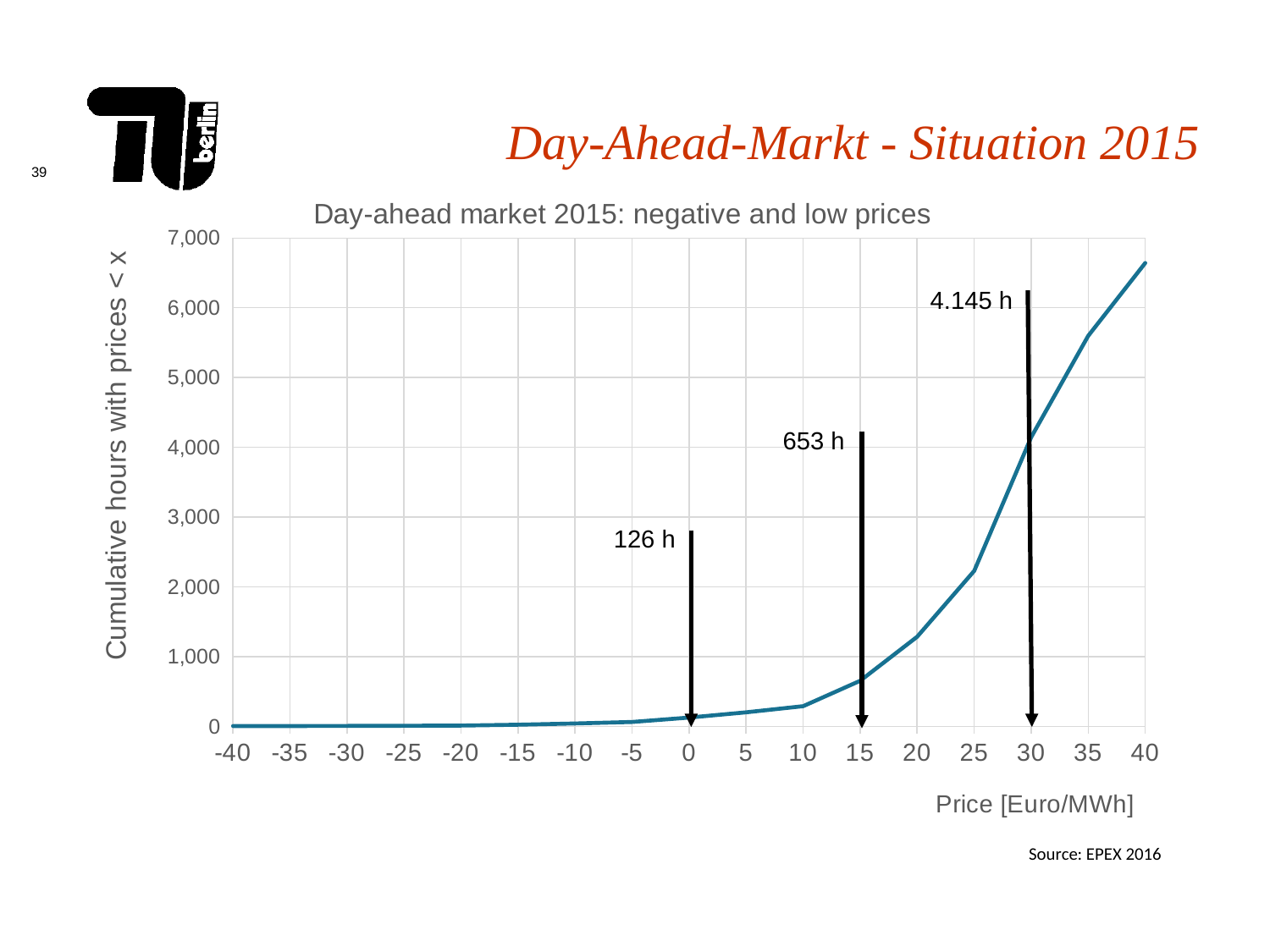
Do the cumulative hours rise or fall as the price increases along the x axis? rise Is the value at a price of -20 Euro/MWh greater or less than 1,000? less What is the label of the x axis? Price [Euro/MWh] According to the annotation, how many cumulative hours had prices below 15 Euro/MWh? 653 h What is the difference between the annotated hours at 15 Euro/MWh and at 0 Euro/MWh? 527 h Is the value at a price of 25 Euro/MWh greater or less than 2,000? greater Which is larger: the annotated hours at 30 Euro/MWh or at 15 Euro/MWh? 30 Euro/MWh What is the title of the chart? Day-ahead market 2015: negative and low prices According to the annotation, how many cumulative hours had prices below 30 Euro/MWh? 4.145 h According to the annotation, how many cumulative hours had prices below 0 Euro/MWh? 126 h What kind of chart is shown on the slide? line chart Is the value at a price of 40 Euro/MWh greater or less than 6,000? greater